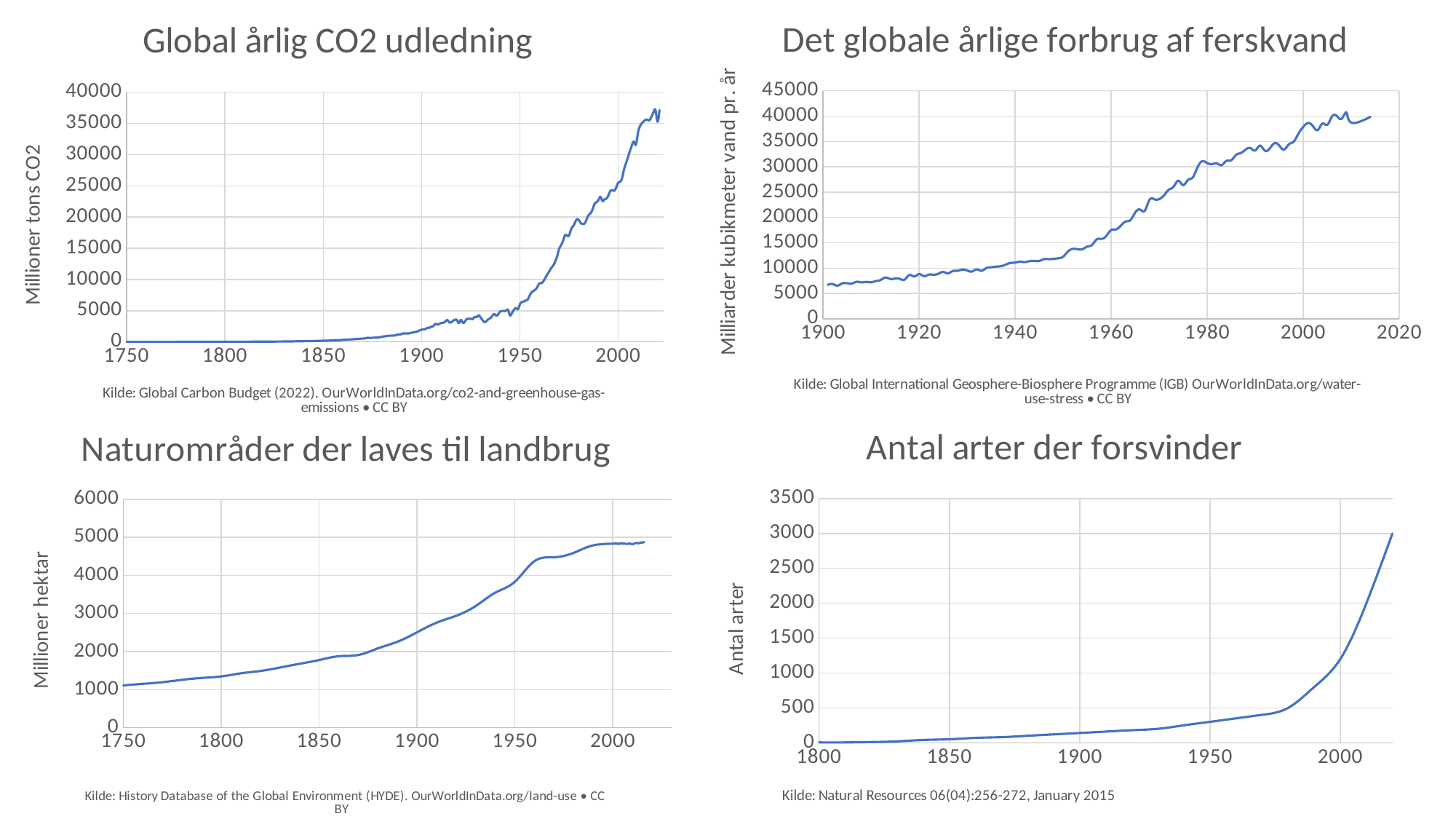
In the chart 'Antal arter der forsvinder', is the value in 1900 greater or less than 500? less In the chart 'Naturområder der laves til landbrug', is the value around the year 2000 greater or less than 4000? greater In the chart 'Det globale årlige forbrug af ferskvand', is the value around the year 2000 greater or less than 30000? greater In the chart 'Antal arter der forsvinder', do the values rise or fall along the x axis? rise What kind of chart is 'Global årlig CO2 udledning'? line chart In the chart 'Global årlig CO2 udledning', do the values rise or fall from 1750 to 2000? rise How many charts are shown on the slide? 4 What is the y-axis label of the chart 'Global årlig CO2 udledning'? Millioner tons CO2